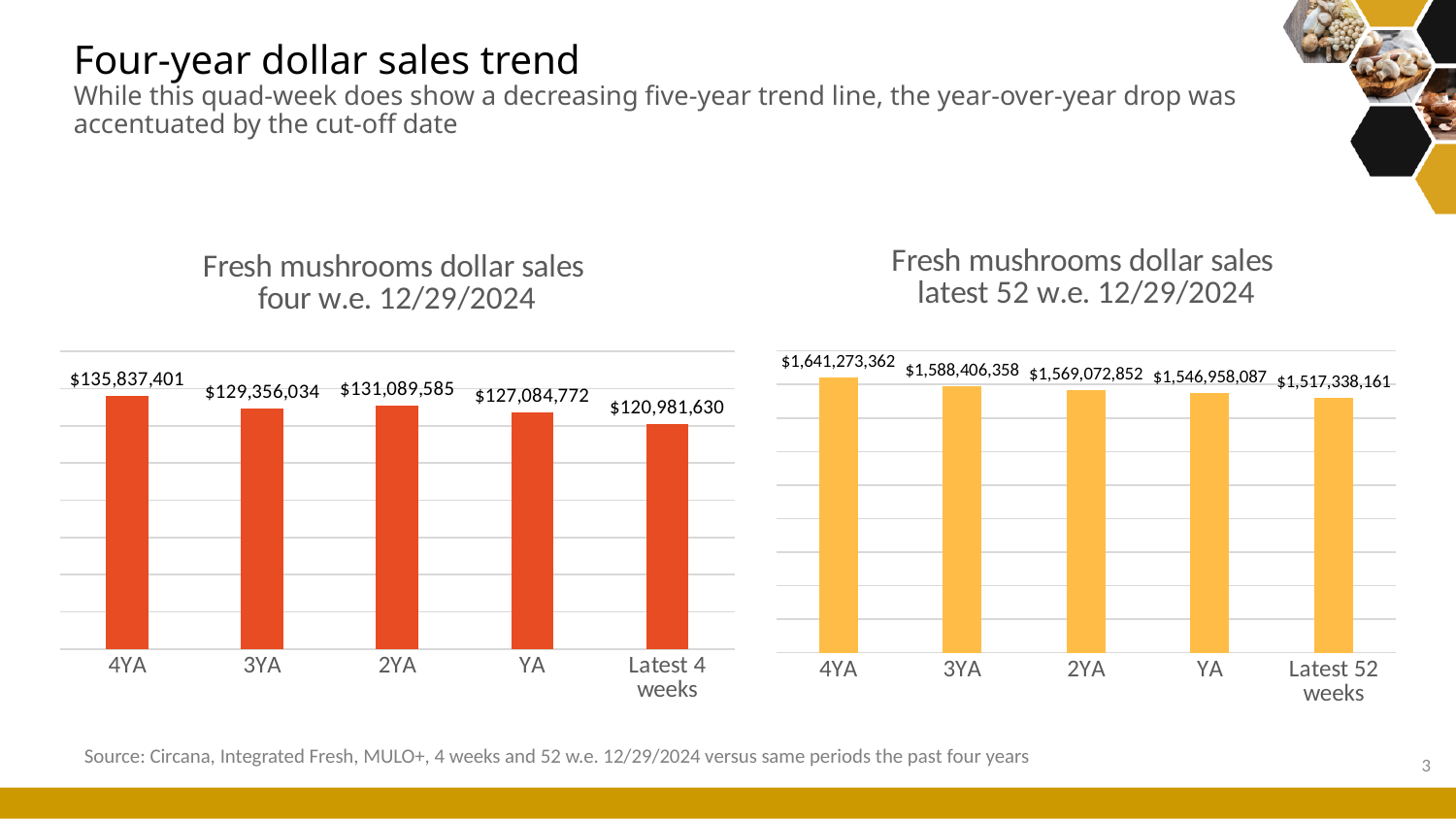
In the 'Fresh mushrooms dollar sales latest 52 w.e. 12/29/2024' chart, which category has the lowest value? Latest 52 weeks In the 'Fresh mushrooms dollar sales four w.e. 12/29/2024' chart, what is the difference between the 4YA value and the Latest 4 weeks value? $14,855,771 In the 'Fresh mushrooms dollar sales four w.e. 12/29/2024' chart, what is the value for Latest 4 weeks? $120,981,630 In the 'Fresh mushrooms dollar sales four w.e. 12/29/2024' chart, which category has the highest value? 4YA In the 'Fresh mushrooms dollar sales four w.e. 12/29/2024' chart, which is larger, the value for 3YA or the value for 2YA? 2YA In the 'Fresh mushrooms dollar sales latest 52 w.e. 12/29/2024' chart, what is the difference between the 4YA value and the Latest 52 weeks value? $123,935,201 What kind of chart is the 'Fresh mushrooms dollar sales four w.e. 12/29/2024' chart? Bar chart In the 'Fresh mushrooms dollar sales latest 52 w.e. 12/29/2024' chart, what is the value for YA? $1,546,958,087 How many categories are shown in the 'Fresh mushrooms dollar sales latest 52 w.e. 12/29/2024' chart? 5 In the 'Fresh mushrooms dollar sales four w.e. 12/29/2024' chart, what is the value for 4YA? $135,837,401 In the 'Fresh mushrooms dollar sales latest 52 w.e. 12/29/2024' chart, what is the value for Latest 52 weeks? $1,517,338,161 In the 'Fresh mushrooms dollar sales latest 52 w.e. 12/29/2024' chart, do the values rise or fall from 4YA to Latest 52 weeks? Fall